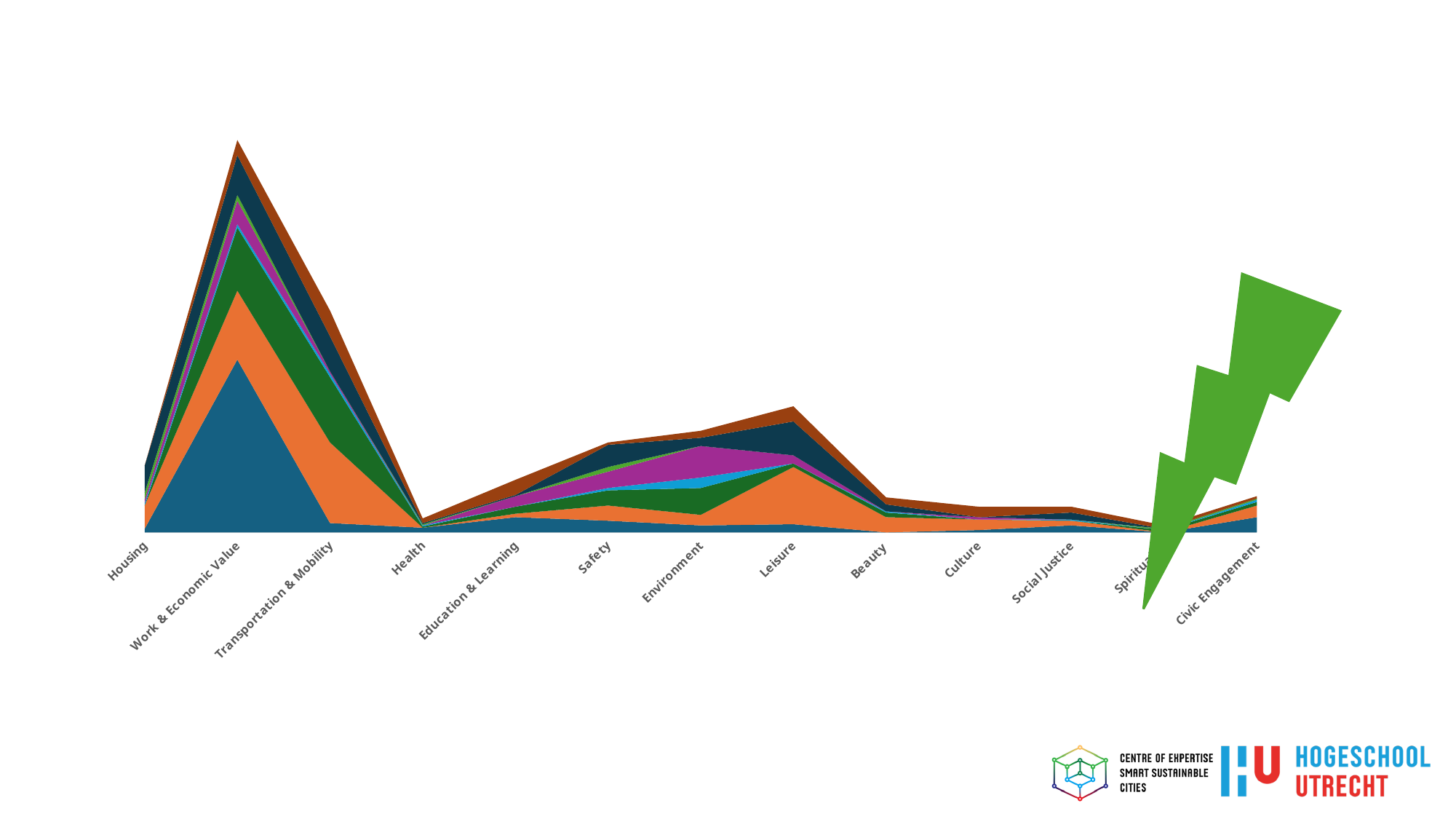
Which has a larger total value, Environment or Beauty? Environment Which has a larger total value, Transportation & Mobility or Health? Transportation & Mobility Do the total values rise or fall from Work & Economic Value to Health? Fall Which category is the first one on the x axis? Housing What kind of chart is shown on the slide? Stacked area chart Do the total values rise or fall from Health to Leisure? Rise Which category has the highest total value in the chart? Work & Economic Value Which category is the last one on the x axis? Civic Engagement How many categories are shown along the x axis of the chart? 13 Which has a larger total value, Safety or Leisure? Leisure